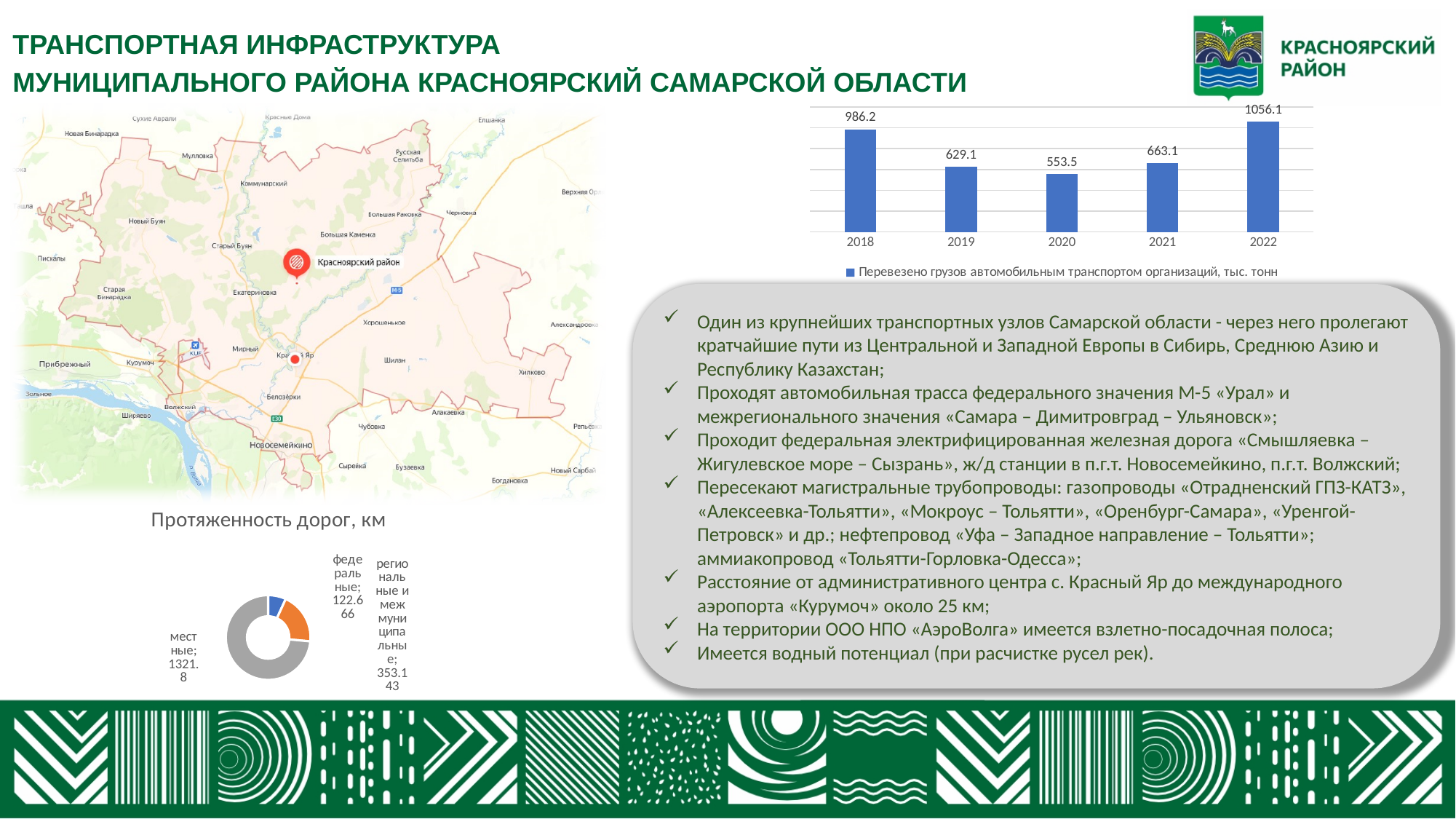
On the chart titled 'Протяженность дорог, км', what is the value for 'федеральные'? 122.666 On the bar chart at the top right, how many years are shown? 5 On the bar chart at the top right, what does the legend say the series is? Перевезено грузов автомобильным транспортом организаций, тыс. тонн On the bar chart at the top right, which year has the lowest value? 2020 On the bar chart at the top right, what is the value for 2022? 1056.1 What kind of chart is the chart titled 'Протяженность дорог, км'? doughnut chart On the chart titled 'Протяженность дорог, км', which category has the largest share? местные On the bar chart at the top right, which year has the highest value? 2022 On the bar chart at the top right, which is larger, the value for 2019 or the value for 2021? 2021 On the bar chart at the top right, what is the difference between the values for 2022 and 2018? 69.9 On the chart titled 'Протяженность дорог, км', what is the value for 'местные'? 1321.8 On the bar chart at the top right, what is the value for 2020? 553.5